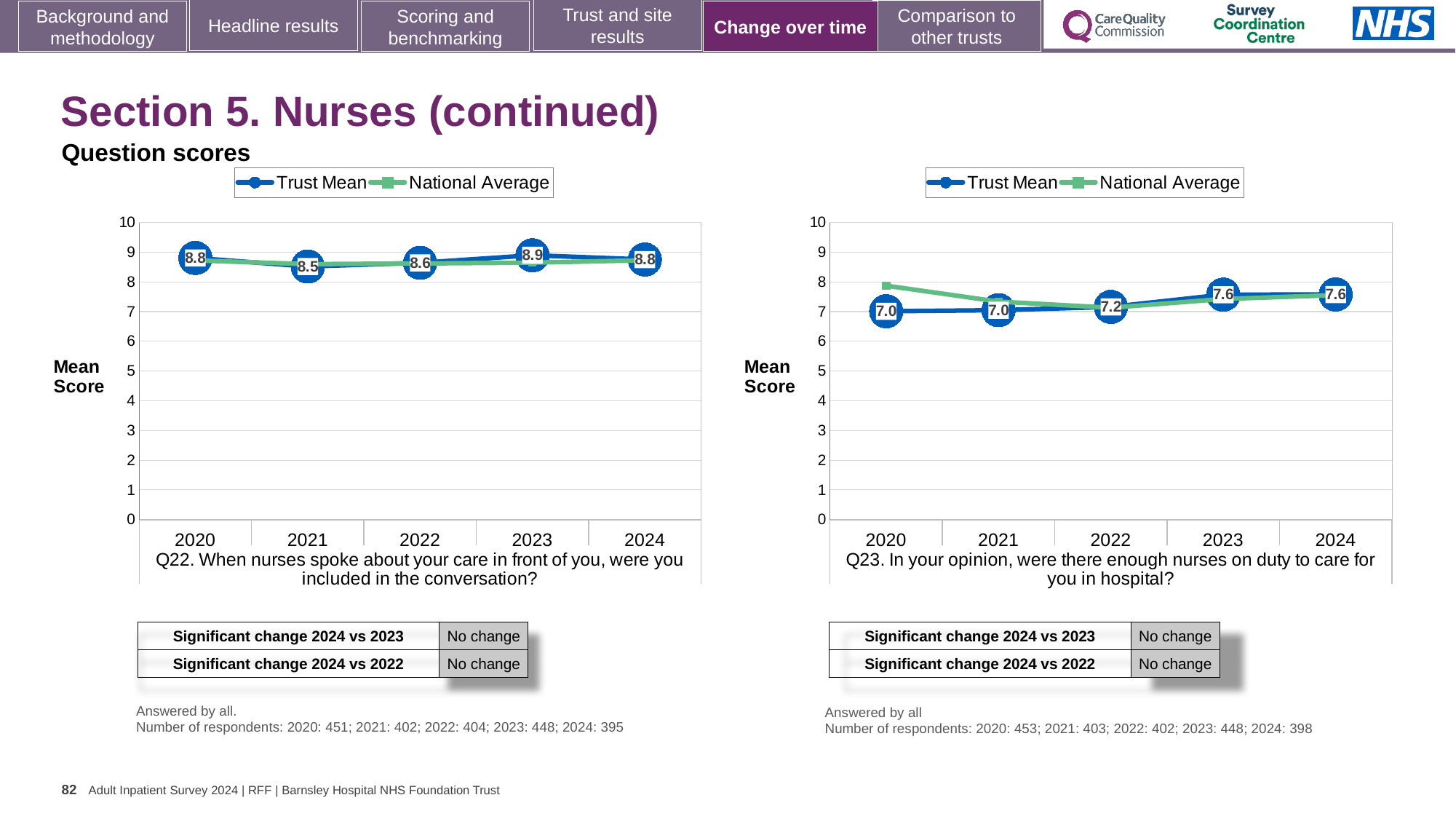
On the Q22 chart (left), what is the Trust Mean score for 2023? 8.9 On the Q23 chart (right), is the Trust Mean score for 2020 greater or less than 8? less On the Q22 chart (left), what is the Trust Mean score for 2021? 8.5 On the Q22 chart (left), what is the difference between the Trust Mean scores for 2023 and 2021? 0.4 On the Q23 chart (right), what is the Trust Mean score for 2022? 7.2 How many years are plotted on the Q22 chart (left)? 5 On the Q23 chart (right), what is the difference between the Trust Mean scores for 2024 and 2020? 0.6 How many series does the legend of the Q23 chart (right) list? 2 On the Q23 chart (right), what is the Trust Mean score for 2024? 7.6 On the Q22 chart (left), which year has the lowest Trust Mean score? 2021 What kind of chart is the Q22 chart (left)? line chart On the Q23 chart (right), does the Trust Mean score rise or fall from 2020 to 2024? rise